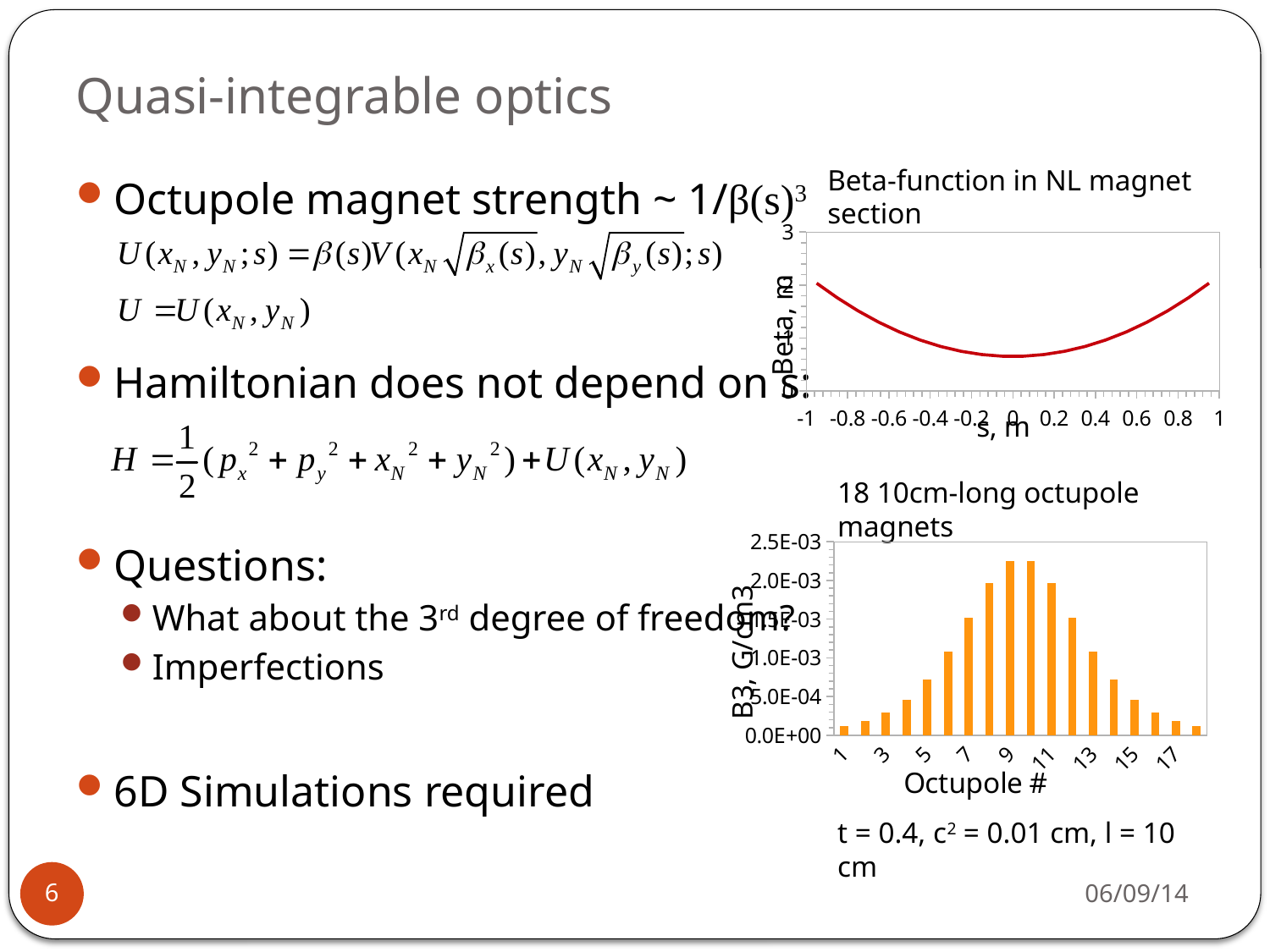
How many bars are plotted in the '18 10cm-long octupole magnets' chart? 18 In the '18 10cm-long octupole magnets' chart, how do the bar values change from octupole 1 to octupole 9? they rise In the '18 10cm-long octupole magnets' chart, which has the larger value, octupole 9 or octupole 1? octupole 9 In the 'Beta-function in NL magnet section' chart, does the beta value rise or fall as s goes from -1 to 0? fall What kind of chart is the '18 10cm-long octupole magnets' chart? bar chart In the '18 10cm-long octupole magnets' chart, is the value for octupole 1 greater or less than 5.0E-04? less What is the y-axis label of the '18 10cm-long octupole magnets' chart? B3, G/cm3 What is the x-axis label of the 'Beta-function in NL magnet section' chart? s, m What kind of chart is the 'Beta-function in NL magnet section' chart? line chart In the '18 10cm-long octupole magnets' chart, is the value for octupole 9 greater or less than 2.0E-03? greater In the 'Beta-function in NL magnet section' chart, is the beta value at s = 0 greater or less than 1? less